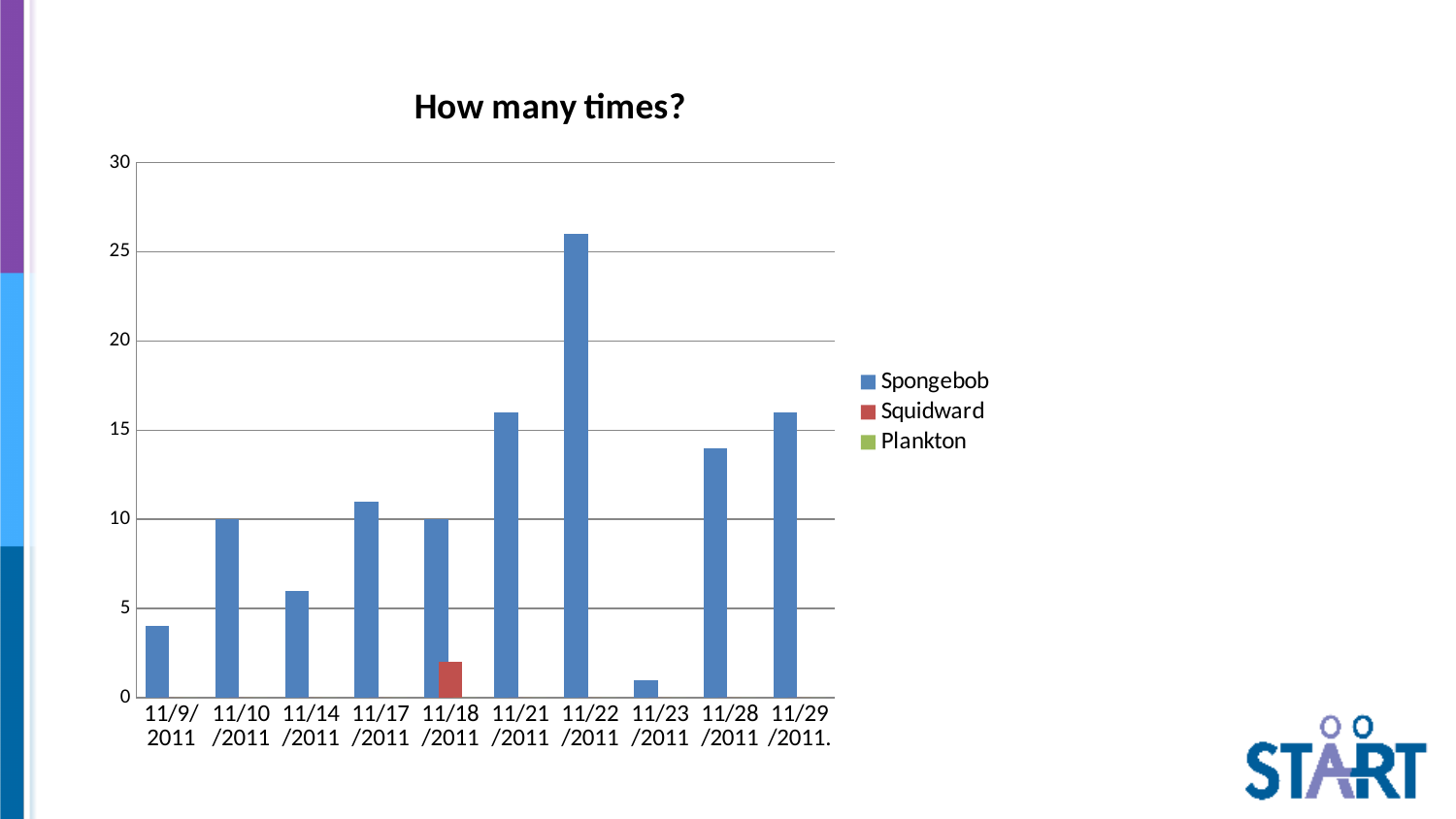
On which date does a Squidward bar appear? 11/18/2011 How many series does the legend list? 3 Is the Spongebob value for 11/9/2011 greater or less than 5? less On which date is the Spongebob value lowest? 11/23/2011 How many dates are shown on the x axis? 10 Which is larger, the Spongebob value for 11/21/2011 or for 11/14/2011? 11/21/2011 On which date is the Spongebob value highest? 11/22/2011 Is the Spongebob value for 11/22/2011 greater or less than 25? greater What type of chart is shown on the slide? bar chart What is the Spongebob value for 11/10/2011? 10 Is the Spongebob value for 11/28/2011 greater or less than 15? less What is the title of the chart? How many times?